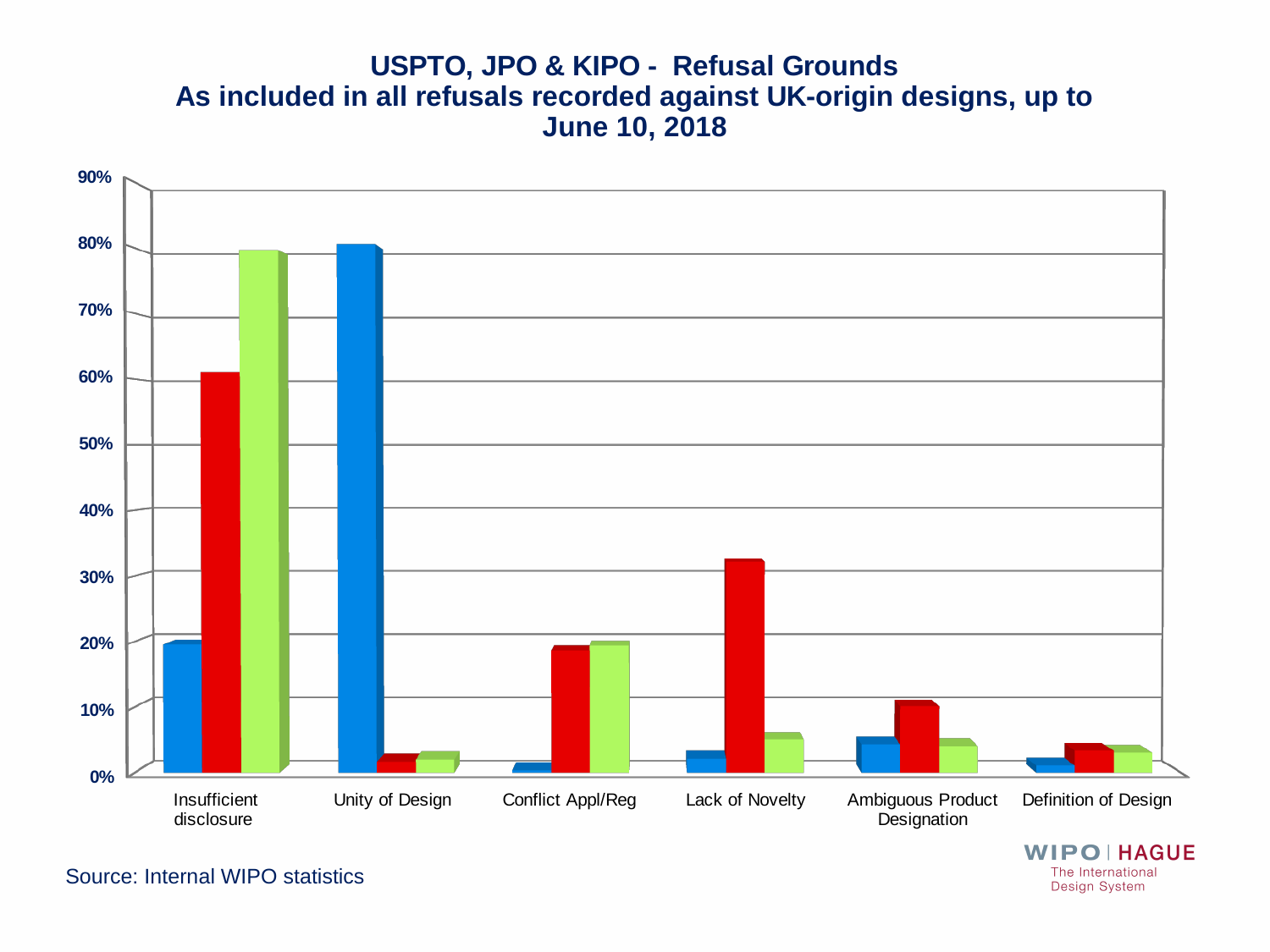
For which category is the red bar the highest? Insufficient disclosure What source is cited for the chart's data? Internal WIPO statistics Is the blue bar for Unity of Design greater or less than 70%? greater For Lack of Novelty, which is larger: the blue bar or the red bar? The red bar Is the green bar for Insufficient disclosure greater or less than 70%? greater For which category is the blue bar the highest? Unity of Design What kind of chart is shown on the slide? Bar chart For which category is the green bar the highest? Insufficient disclosure How many refusal-ground categories are shown along the x axis? 6 Is the red bar for Insufficient disclosure greater or less than 50%? greater For Insufficient disclosure, which is larger: the red bar or the green bar? The green bar